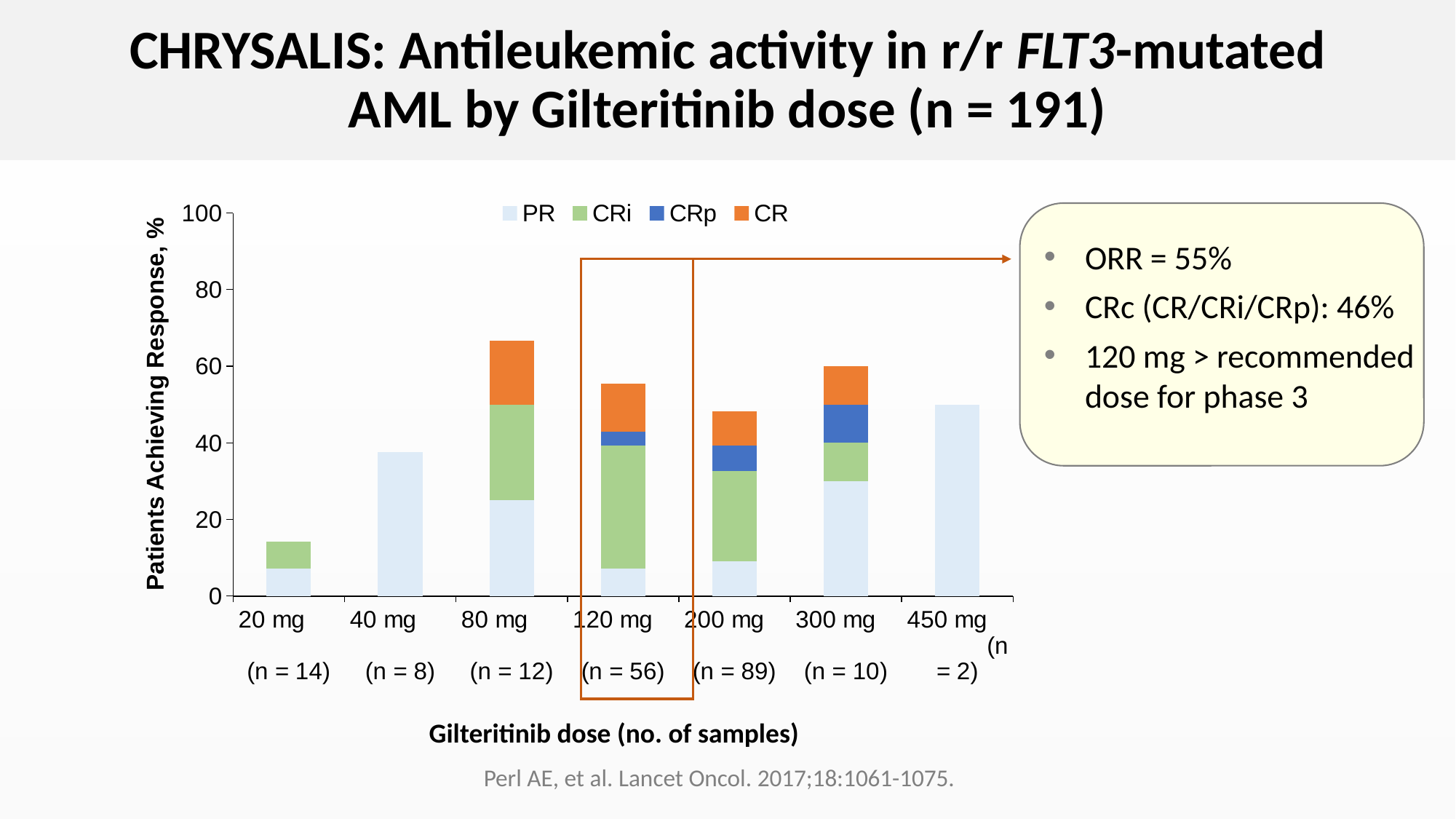
Which dose is highlighted with an orange box on the chart? 120 mg What kind of chart is shown on the slide? stacked bar chart How many series does the legend list? 4 Which has a larger total response, the 80 mg dose or the 200 mg dose? 80 mg Which dose has the lowest total percentage of patients achieving response? 20 mg Is the total response for the 450 mg dose greater or less than 40? greater Is the total response for the 20 mg dose greater or less than 20? less Which dose has the highest total percentage of patients achieving response? 80 mg What are the four series listed in the legend? PR, CRi, CRp, CR Is the total response for the 120 mg dose greater or less than 40? greater How many gilteritinib dose categories are shown on the x axis? 7